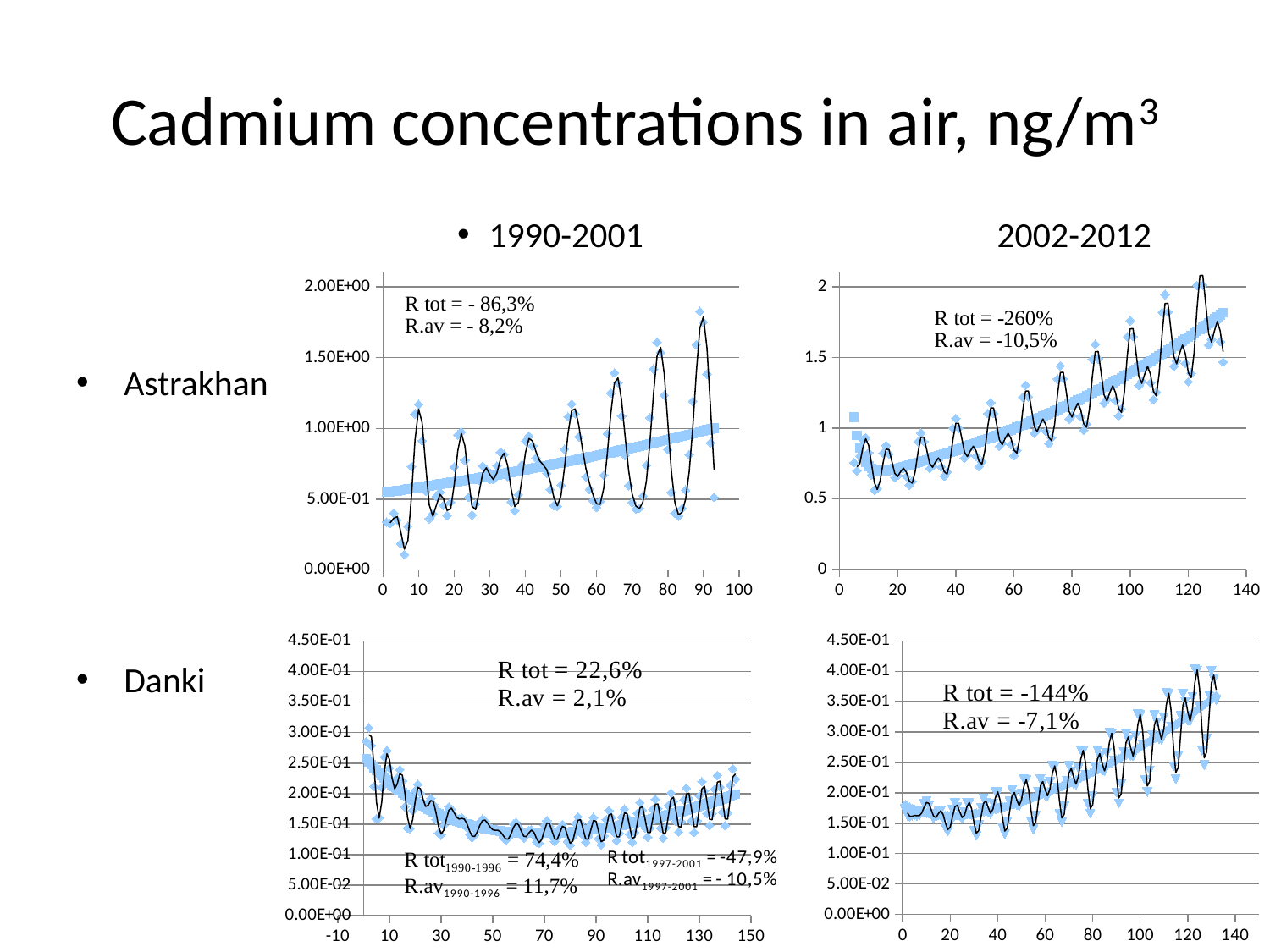
In the Astrakhan 2002-2012 chart (top-right), are the values near x = 10 greater or less than 1? less In the Astrakhan 2002-2012 chart (top-right), do the values generally rise or fall along the x axis? rise What R tot value is printed on the Astrakhan 2002-2012 chart (top-right)? -260% In the Astrakhan 1990-2001 chart (top-left), does the straight trend line rise or fall along the x axis? rise In the Danki 2002-2012 chart (bottom-right), are the values near x = 120 greater or less than 3.00E-01? greater In the Astrakhan 1990-2001 chart (top-left), is the peak value near x = 90 greater or less than 1.50E+00? greater How many charts are shown on the slide? 4 What kind of chart is the Danki 2002-2012 chart (bottom-right)? scatter chart In the Danki 2002-2012 chart (bottom-right), do the values generally rise or fall along the x axis? rise What kind of chart is the Astrakhan 1990-2001 chart (top-left)? scatter chart